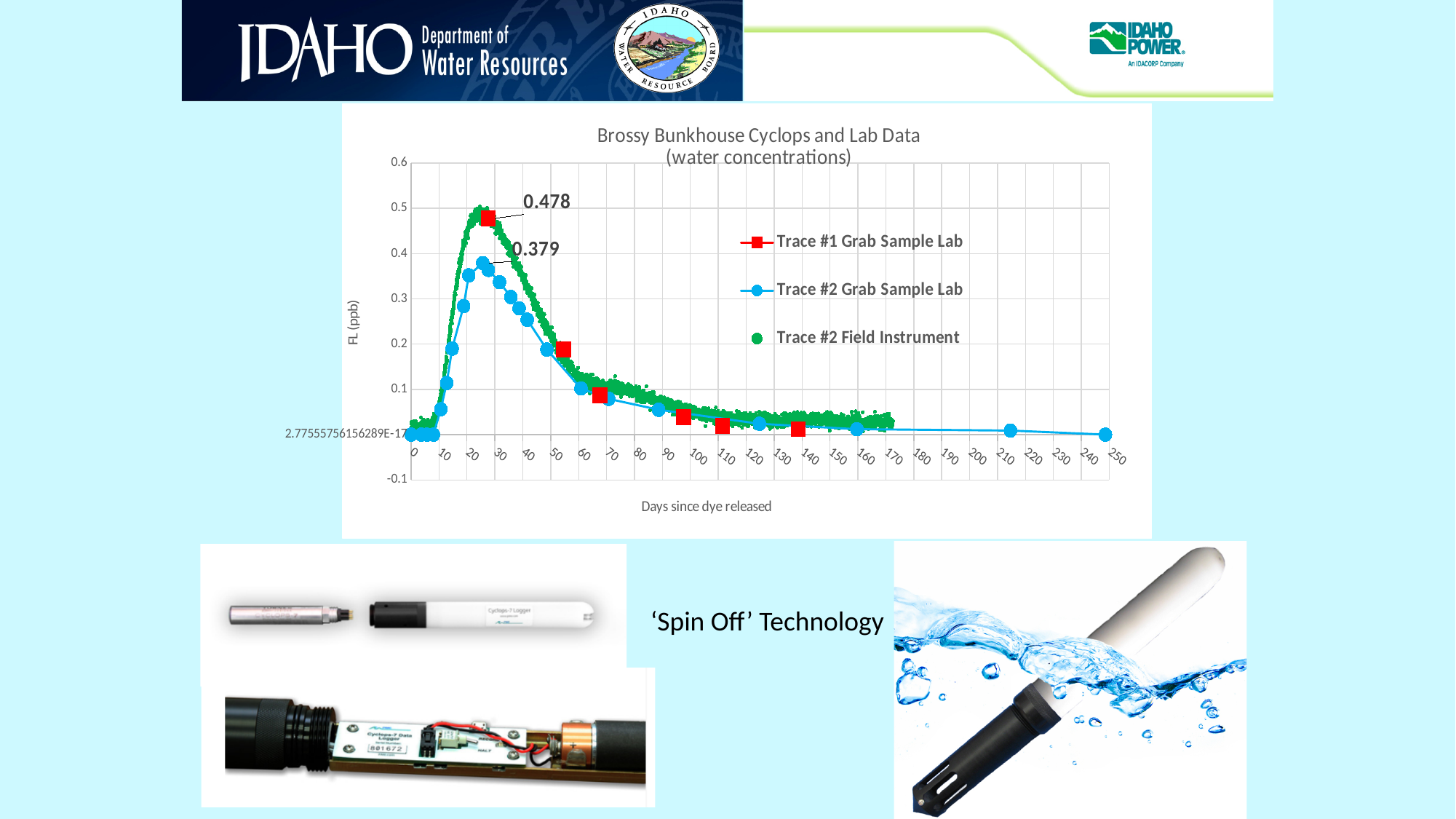
Is the labelled peak value of Trace #2 Grab Sample Lab greater or less than 0.4? less What is the label of the x axis? Days since dye released What is the title of the chart? Brossy Bunkhouse Cyclops and Lab Data (water concentrations) What kind of chart is shown on the slide? line chart What is the labelled peak value of the Trace #1 Grab Sample Lab series? 0.478 Is the labelled peak value of Trace #1 Grab Sample Lab greater or less than 0.4? greater Which series has the higher labelled peak value, Trace #1 Grab Sample Lab or Trace #2 Grab Sample Lab? Trace #1 Grab Sample Lab Is the last Trace #2 Grab Sample Lab point, near day 245, greater or less than 0.1? less What is the labelled peak value of the Trace #2 Grab Sample Lab series? 0.379 After the peak near day 25, do the values rise or fall as days since dye released increase? fall How many series does the chart legend list? 3 What is the difference between the labelled peak values 0.478 and 0.379? 0.099